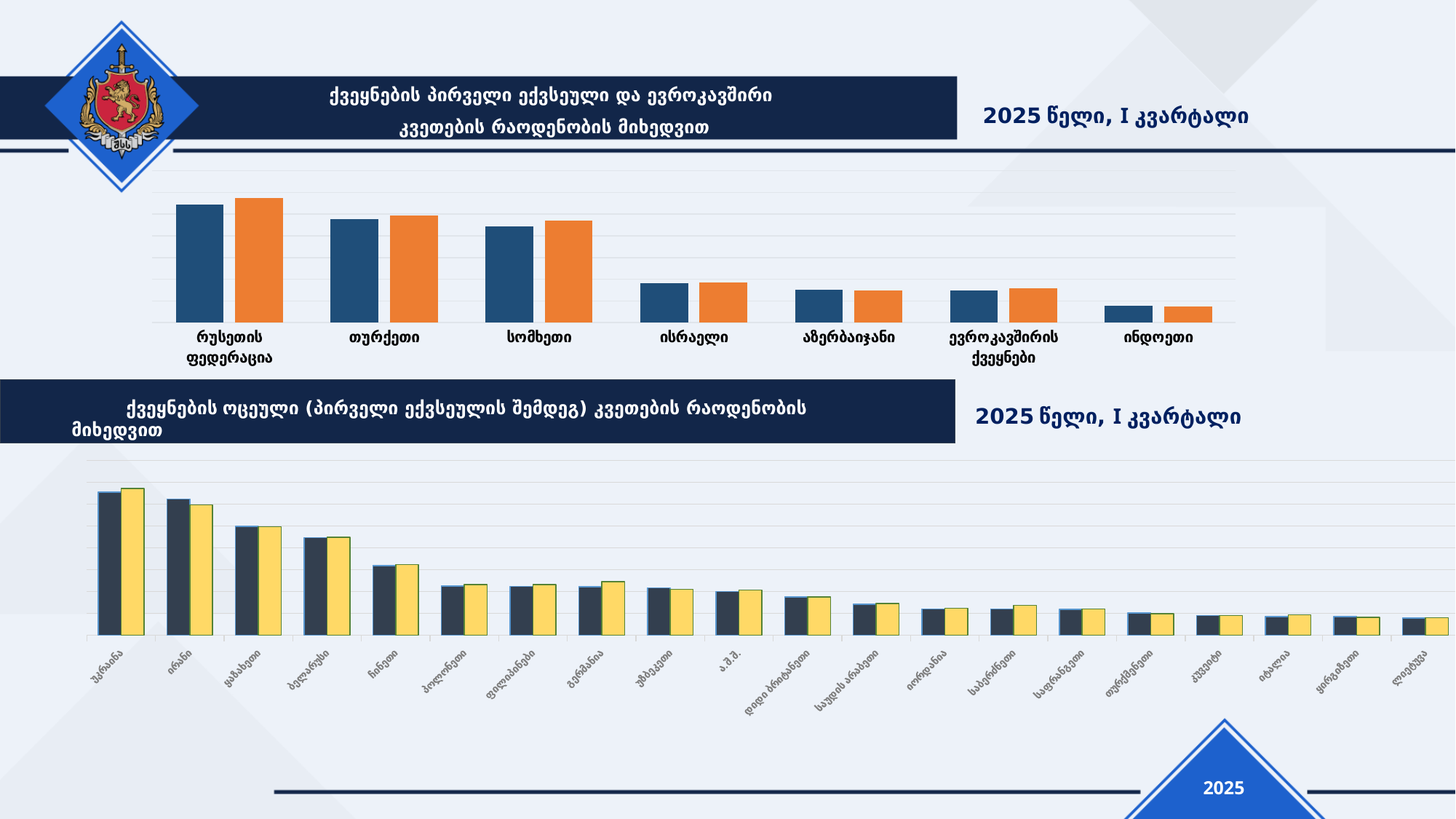
In the top chart, which category has the lowest bars? ინდოეთი What kind of chart is the bottom chart on the slide? bar chart In the bottom chart, which category has the highest bars? უკრაინა In the top chart, which is larger: the value for რუსეთის ფედერაცია or the value for ისრაელი? რუსეთის ფედერაცია In the bottom chart, how many countries/categories are shown on the x axis? 20 What kind of chart is the top chart on the slide? bar chart What period is stated next to the title of the top chart? 2025 წელი, I კვარტალი What two colours are the bars in the top chart? blue and orange In the top chart, how many countries/categories are shown on the x axis? 7 In the bottom chart, which is larger: the value for უკრაინა or the value for ჩინეთი? უკრაინა In the top chart, which category has the highest bars? რუსეთის ფედერაცია In the bottom chart, do the values generally rise or fall from left to right along the x axis? fall